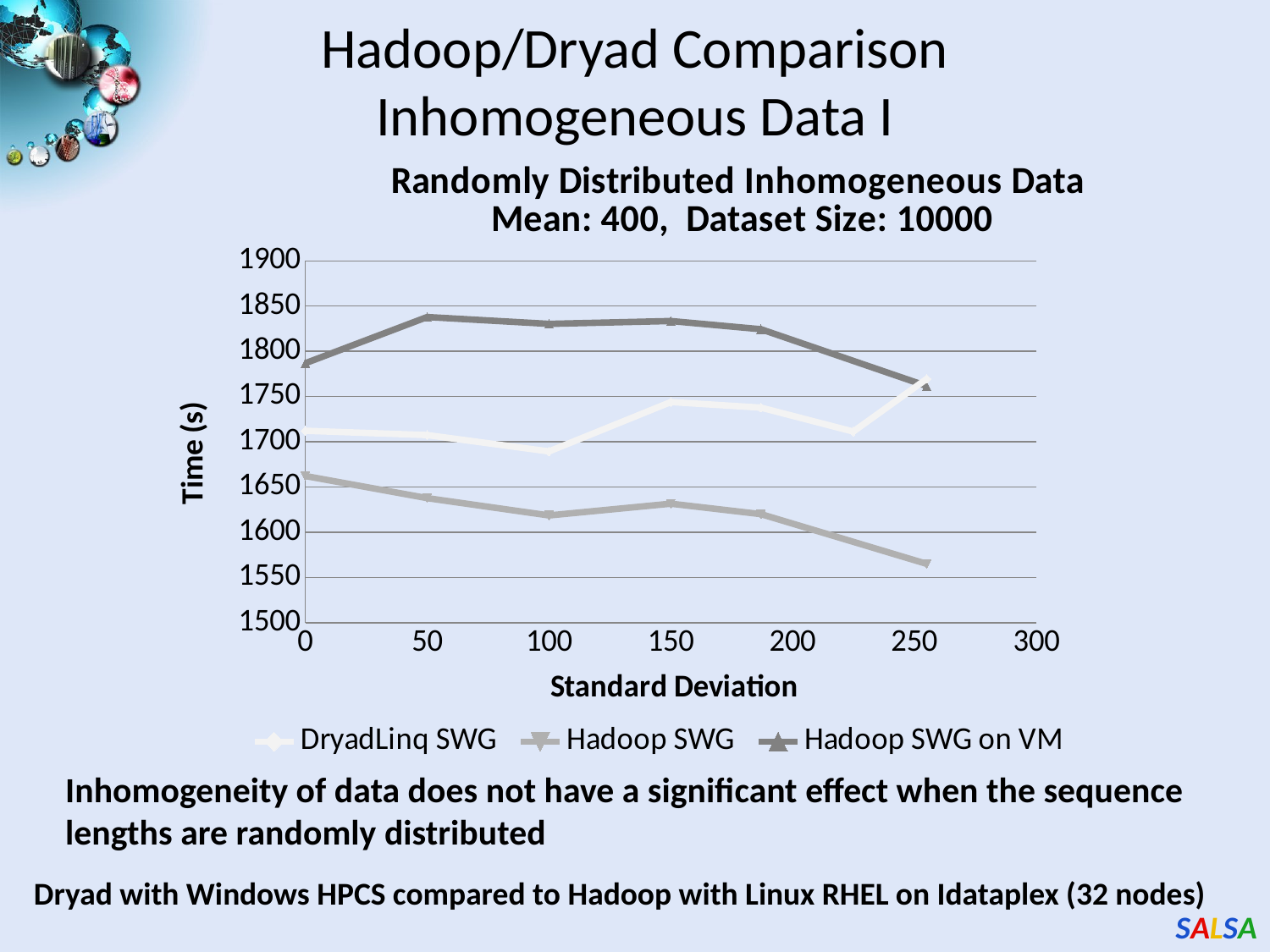
What kind of chart is shown on the slide? line chart Does the Hadoop SWG series rise or fall as standard deviation increases? fall At standard deviation 50, which is larger: Hadoop SWG on VM or Hadoop SWG? Hadoop SWG on VM Which series has the highest time values across the chart? Hadoop SWG on VM Is the value for DryadLinq SWG at standard deviation 150 greater or less than 1700? greater Is the value for Hadoop SWG at standard deviation 250 greater or less than 1600? less What is the label of the y axis of the chart? Time (s) How many series does the chart legend list? 3 Is the value for Hadoop SWG on VM at standard deviation 50 greater or less than 1800? greater What is the title of the chart? Randomly Distributed Inhomogeneous Data Mean: 400, Dataset Size: 10000 Which series has the lowest time values across the chart? Hadoop SWG